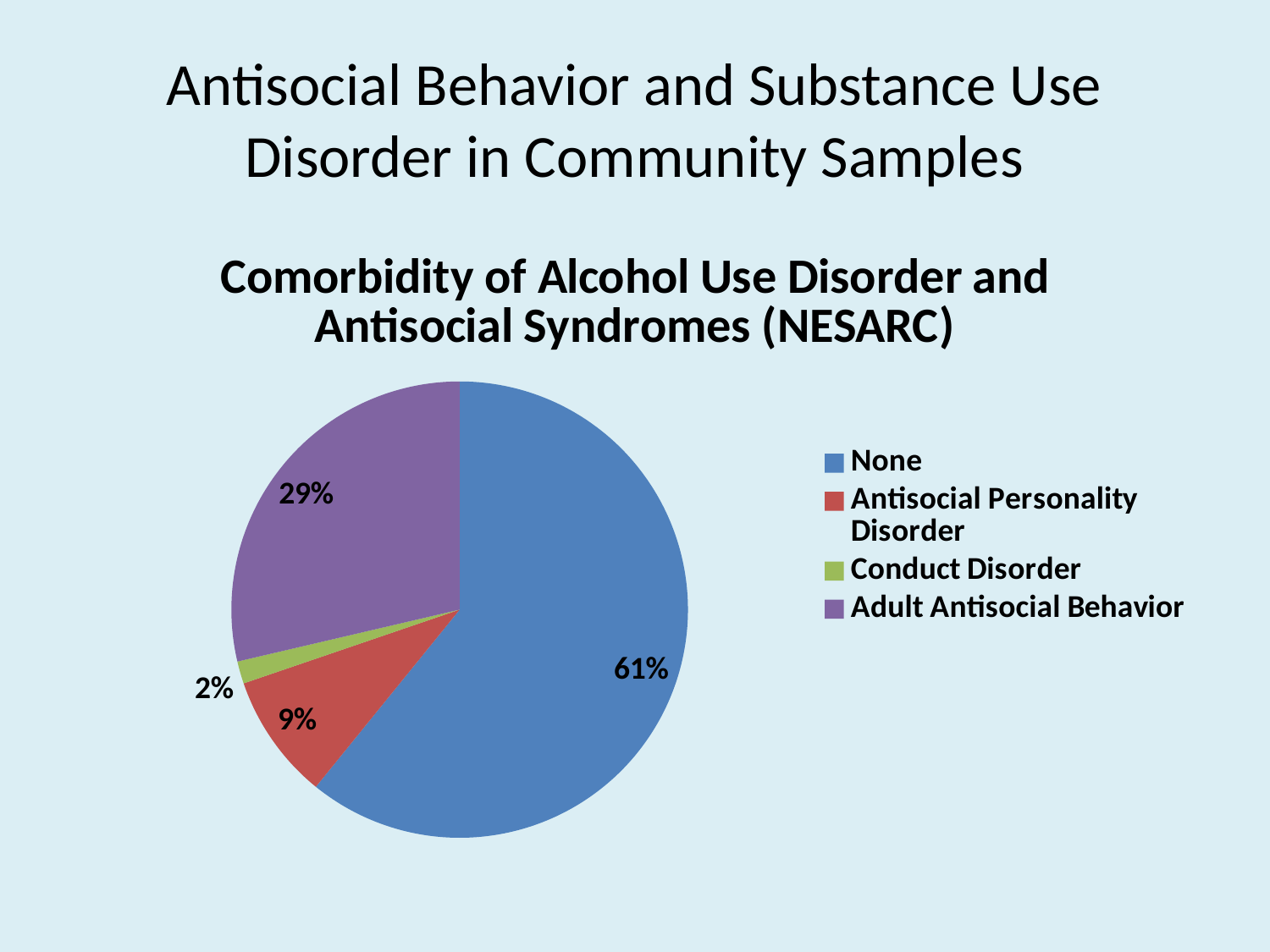
What colour is the Conduct Disorder slice? green What share of the pie is Conduct Disorder? 2% Which category has the largest slice of the pie? None How many categories does the pie chart show? 4 What share of the pie is labelled None? 61% Which is larger, the Antisocial Personality Disorder slice or the Adult Antisocial Behavior slice? Adult Antisocial Behavior What kind of chart is shown on the slide? pie chart What share of the pie is Antisocial Personality Disorder? 9% What is the chart's title? Comorbidity of Alcohol Use Disorder and Antisocial Syndromes (NESARC) What is the difference in percentage points between the None slice and the Adult Antisocial Behavior slice? 32 Which category has the smallest slice of the pie? Conduct Disorder